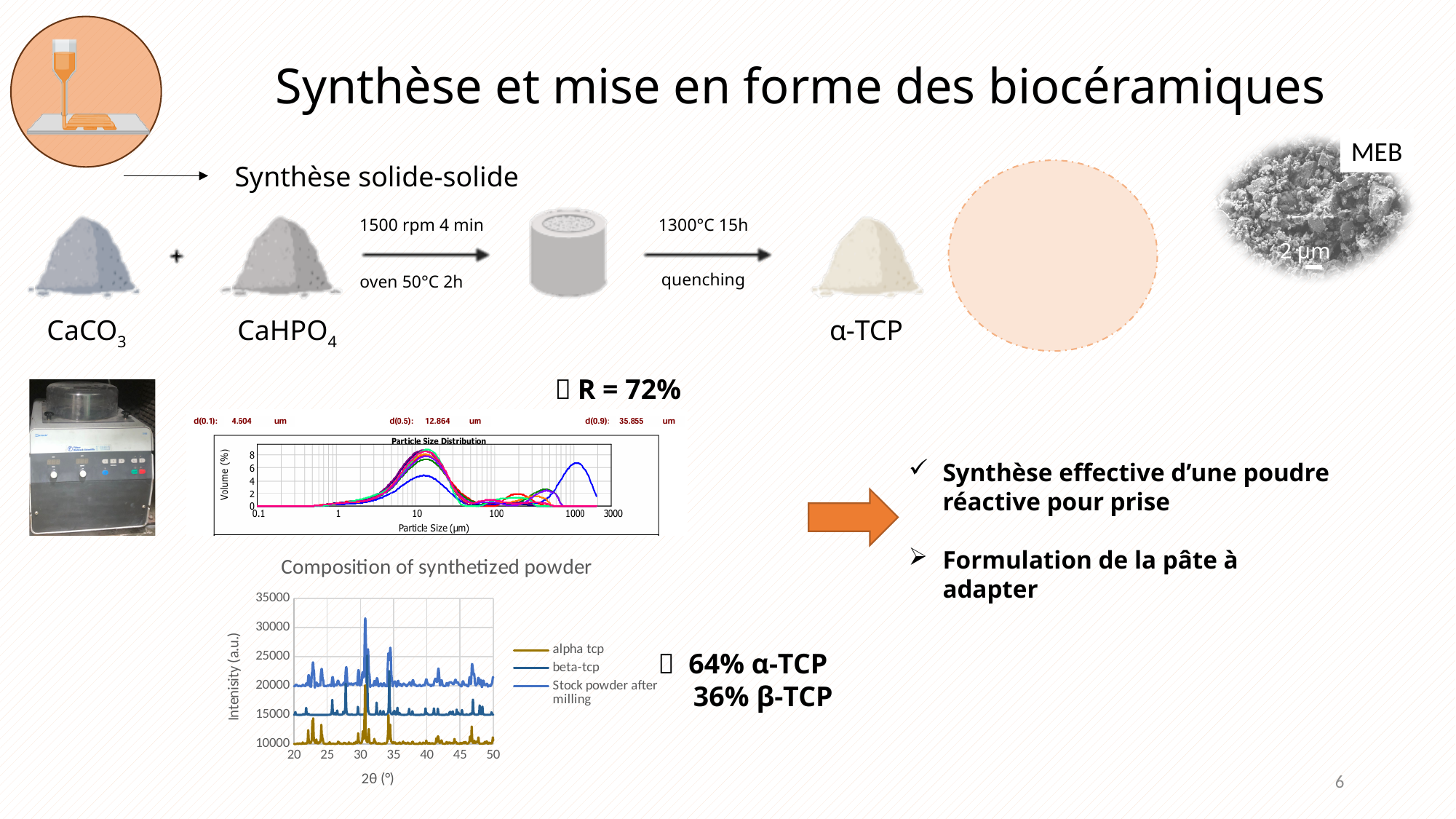
What kind of chart is the Particle Size Distribution chart? line chart What is the d(0.5) value printed above the Particle Size Distribution chart? 12.864 um On the 'Composition of synthetized powder' chart, which series is drawn in gold/yellow? alpha tcp On the Particle Size Distribution chart, what is the label of the x axis? Particle Size (µm) How many series does the legend of the 'Composition of synthetized powder' chart list? 3 What kind of chart is the 'Composition of synthetized powder' chart? line chart On the 'Composition of synthetized powder' chart, what is the highest tick value shown on the y axis? 35000 On the 'Composition of synthetized powder' chart, what is the range of the x axis (2θ) shown by the ticks? 20 to 50 What is the d(0.9) value printed above the Particle Size Distribution chart? 35.855 um